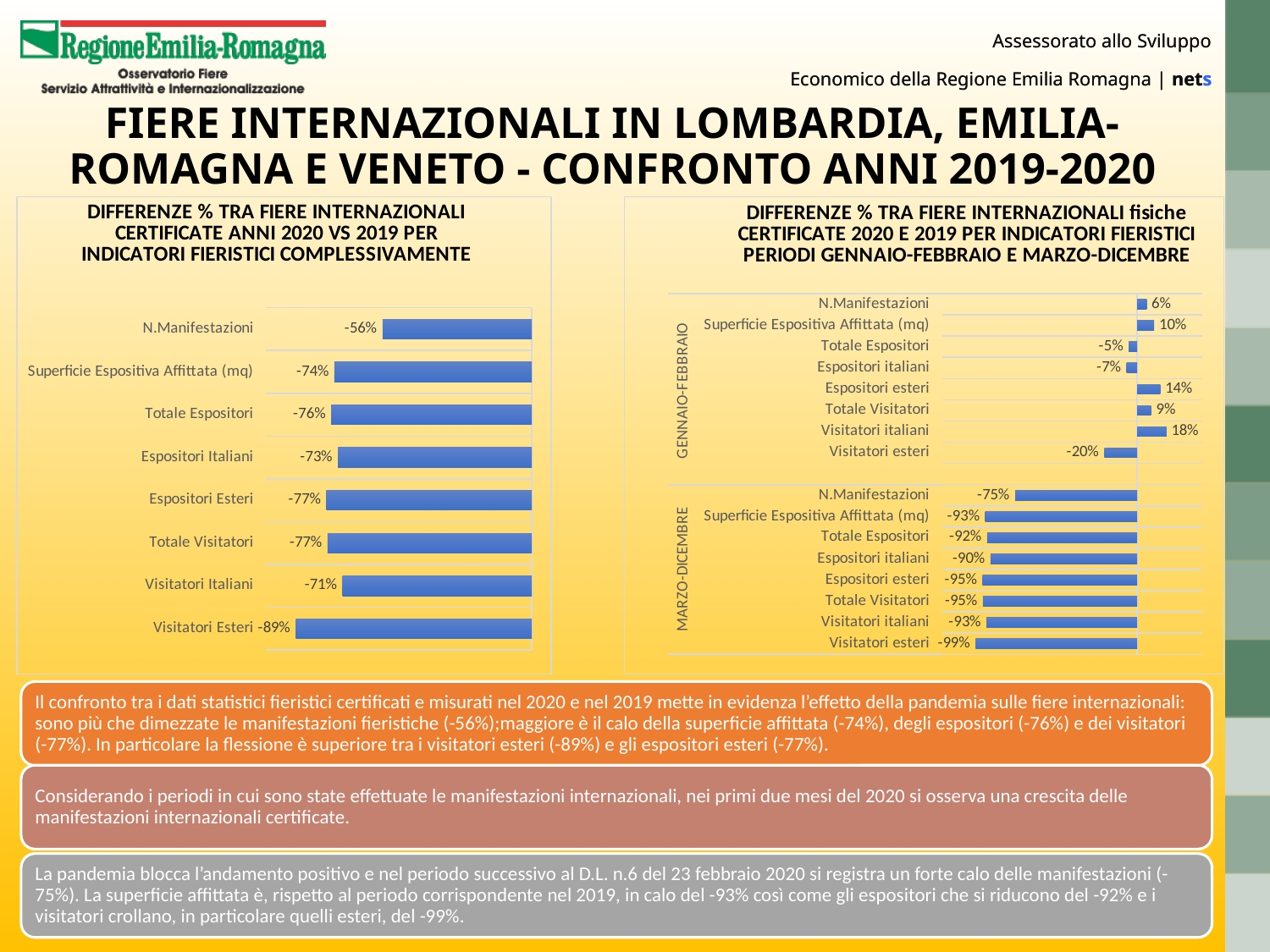
In the left chart (Differenze % ... complessivamente), what is the value for Visitatori Esteri? -89% In the left chart (Differenze % ... complessivamente), what is the difference between the values for Totale Espositori and Espositori Italiani? 3 percentage points In the right chart (periodi Gennaio-Febbraio e Marzo-Dicembre), what is the difference between N.Manifestazioni in Gennaio-Febbraio and N.Manifestazioni in Marzo-Dicembre? 81 percentage points How many categories are shown in the left chart (Differenze % ... complessivamente)? 8 In the right chart (periodi Gennaio-Febbraio e Marzo-Dicembre), what is the value for Visitatori esteri in the Marzo-Dicembre period? -99% What type of chart is the left chart (Differenze % ... complessivamente)? Bar chart In the right chart (periodi Gennaio-Febbraio e Marzo-Dicembre), what is the value for Visitatori italiani in the Gennaio-Febbraio period? 18% In the left chart (Differenze % ... complessivamente), which category has the highest (least negative) value? N.Manifestazioni In the right chart (periodi Gennaio-Febbraio e Marzo-Dicembre), which indicator has the highest value in the Gennaio-Febbraio period? Visitatori italiani In the left chart (Differenze % ... complessivamente), which category has the lowest (most negative) value? Visitatori Esteri In the left chart (Differenze % ... complessivamente), what is the value for N.Manifestazioni? -56% In the right chart (periodi Gennaio-Febbraio e Marzo-Dicembre), which is larger: Espositori esteri in Gennaio-Febbraio or Totale Visitatori in Gennaio-Febbraio? Espositori esteri